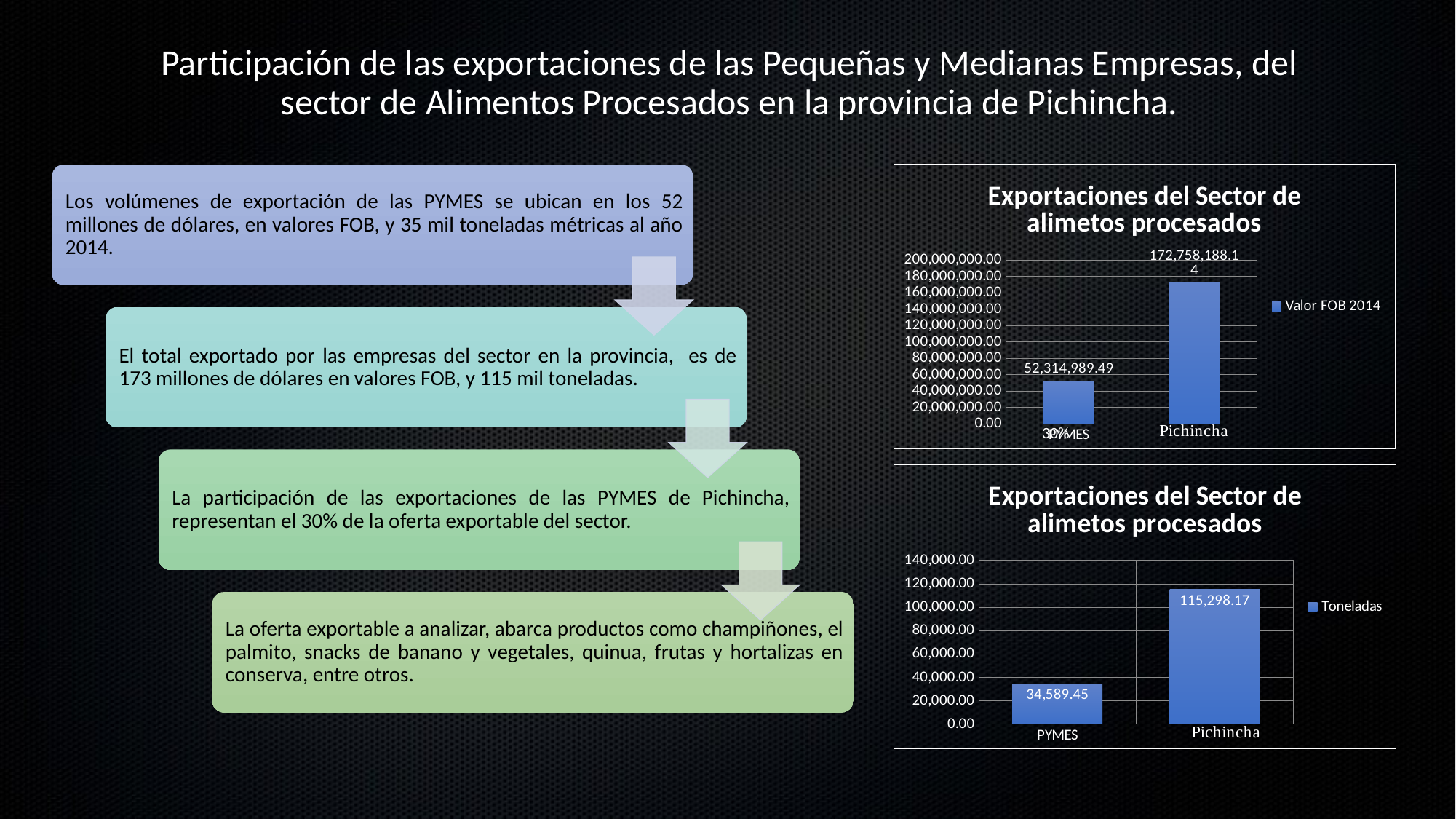
In the bottom chart (Toneladas), what is the difference between the Pichincha and PYMES values? 80,708.72 In the bottom chart (Toneladas), what is the value for Pichincha? 115,298.17 In the top chart (Valor FOB 2014), which category has the highest value? Pichincha How many categories are shown in the bottom chart (Toneladas)? 2 What kind of chart is the top chart (Valor FOB 2014)? Bar chart In the top chart (Valor FOB 2014), what is the difference between the Pichincha and PYMES values? 120,443,198.65 In the bottom chart (Toneladas), which category has the lowest value? PYMES In the top chart (Valor FOB 2014), what is the value for Pichincha? 172,758,188.14 In the bottom chart (Toneladas), what is the value for PYMES? 34,589.45 In the top chart (Valor FOB 2014), what is the value for PYMES? 52,314,989.49 In the bottom chart (Toneladas), is the value for Pichincha greater or less than 100,000.00? greater In the top chart (Valor FOB 2014), what series does the legend list? Valor FOB 2014